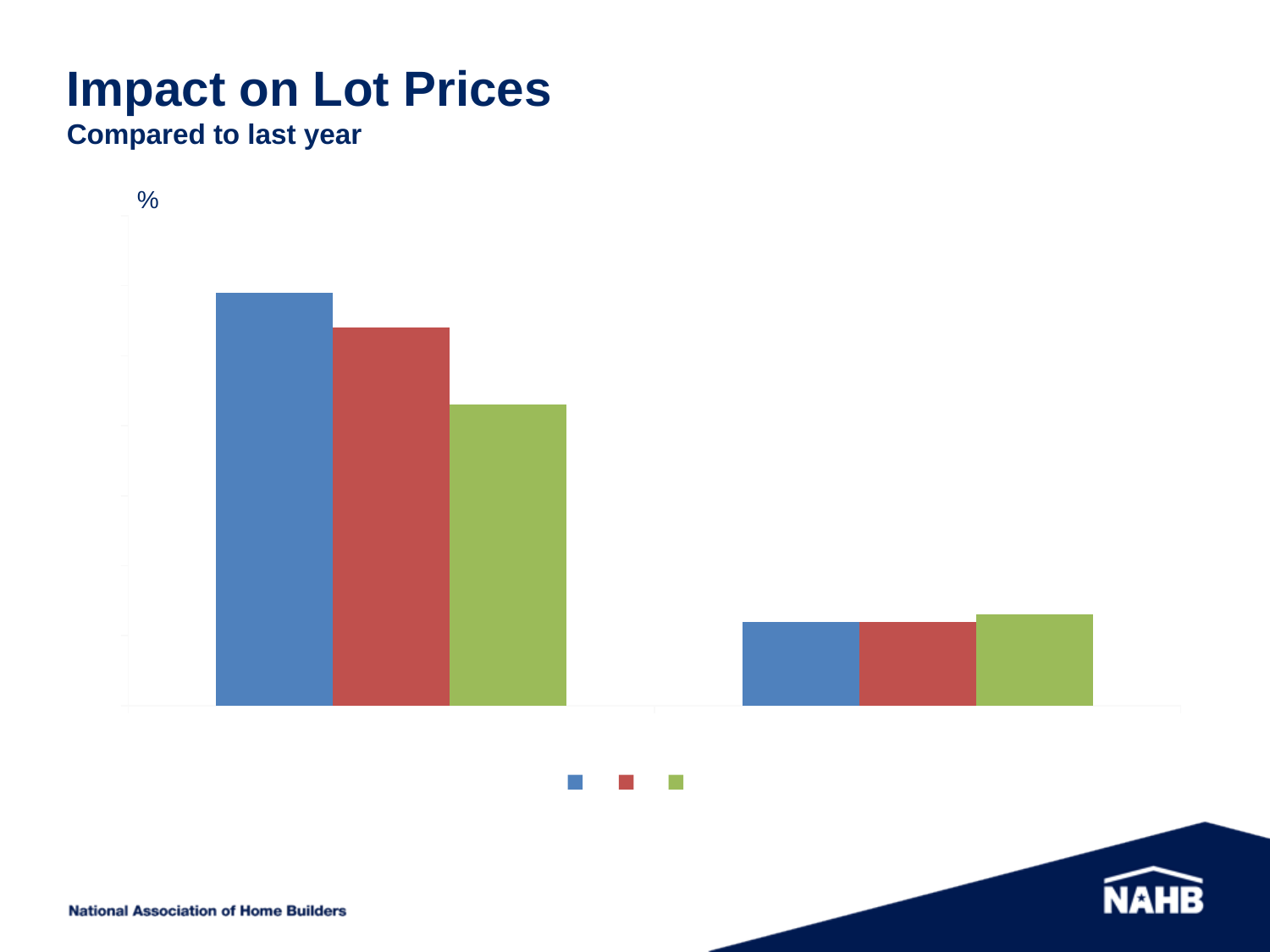
In the right group of bars, which colour bar is the tallest? green How many bars are plotted in total on the chart? 6 What unit is shown at the top of the vertical axis? % What is the title of the chart on the slide? Impact on Lot Prices Do the values of the blue series rise or fall from the left group to the right group? fall What kind of chart is shown on the slide? bar chart In the left group, is the red bar taller or shorter than the green bar? taller In the left group of bars, which colour bar is the tallest? blue In the left group of bars, which colour bar is the shortest? green Which group of bars has the larger values, the left group or the right group? the left group How many series does the legend list? 3 How many groups of bars are plotted on the chart? 2